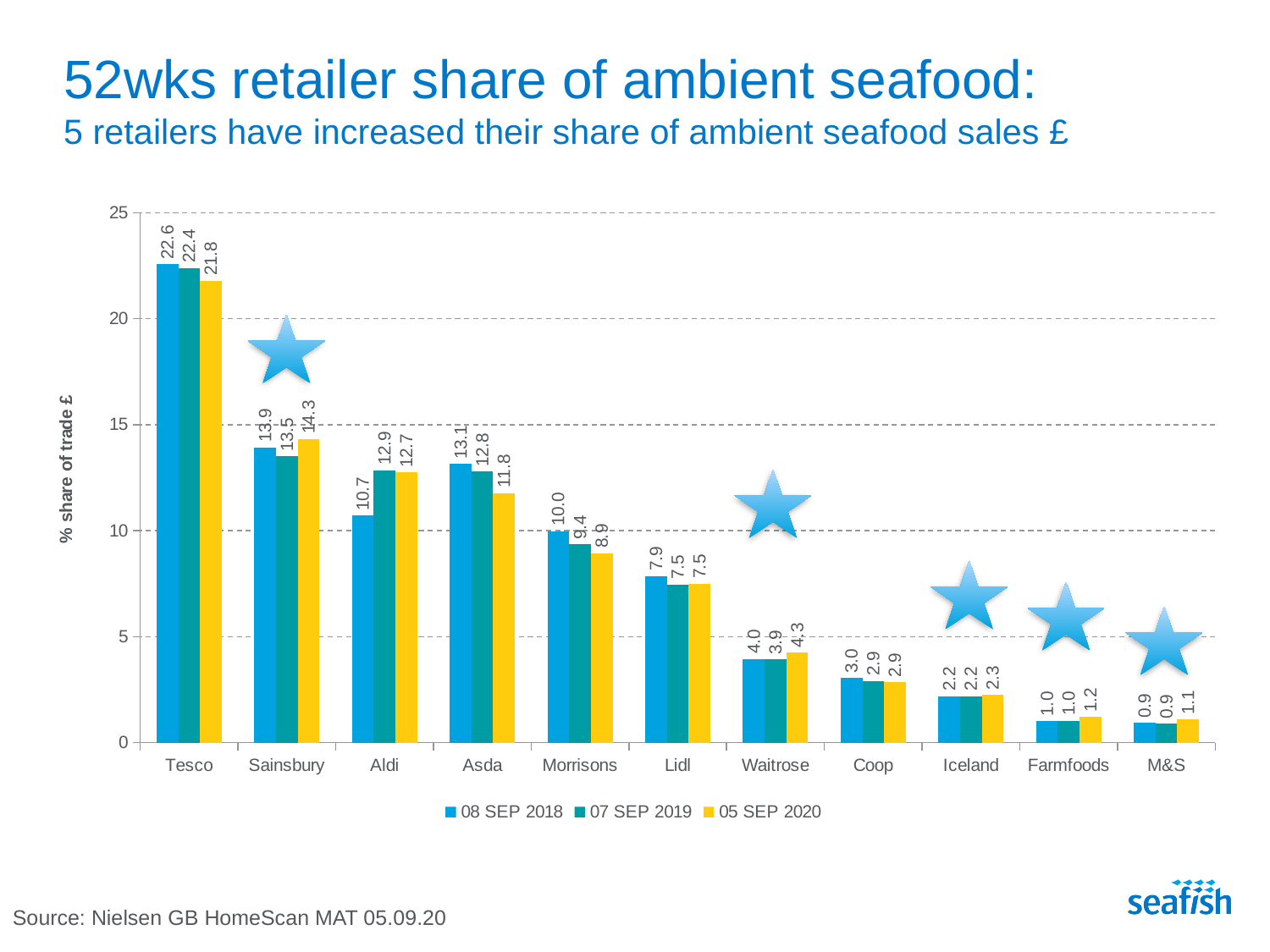
What is the difference between Asda's 08 SEP 2018 value and its 05 SEP 2020 value? 1.3 What is the label of the y axis? % share of trade £ What is Sainsbury's share of trade for 08 SEP 2018? 13.9 Is Morrisons' value for 08 SEP 2018 greater or less than 5? greater Which retailer has the lowest share of trade in the 08 SEP 2018 series? M&S How many retailers are shown on the x axis? 11 Which is larger for 05 SEP 2020: Aldi or Asda? Aldi Which retailer has the highest share of trade in the 05 SEP 2020 series? Tesco What kind of chart is shown on the slide? Bar chart What is the value for Waitrose in the 07 SEP 2019 series? 3.9 What is Tesco's share of trade for 05 SEP 2020? 21.8 How many series does the legend list? 3